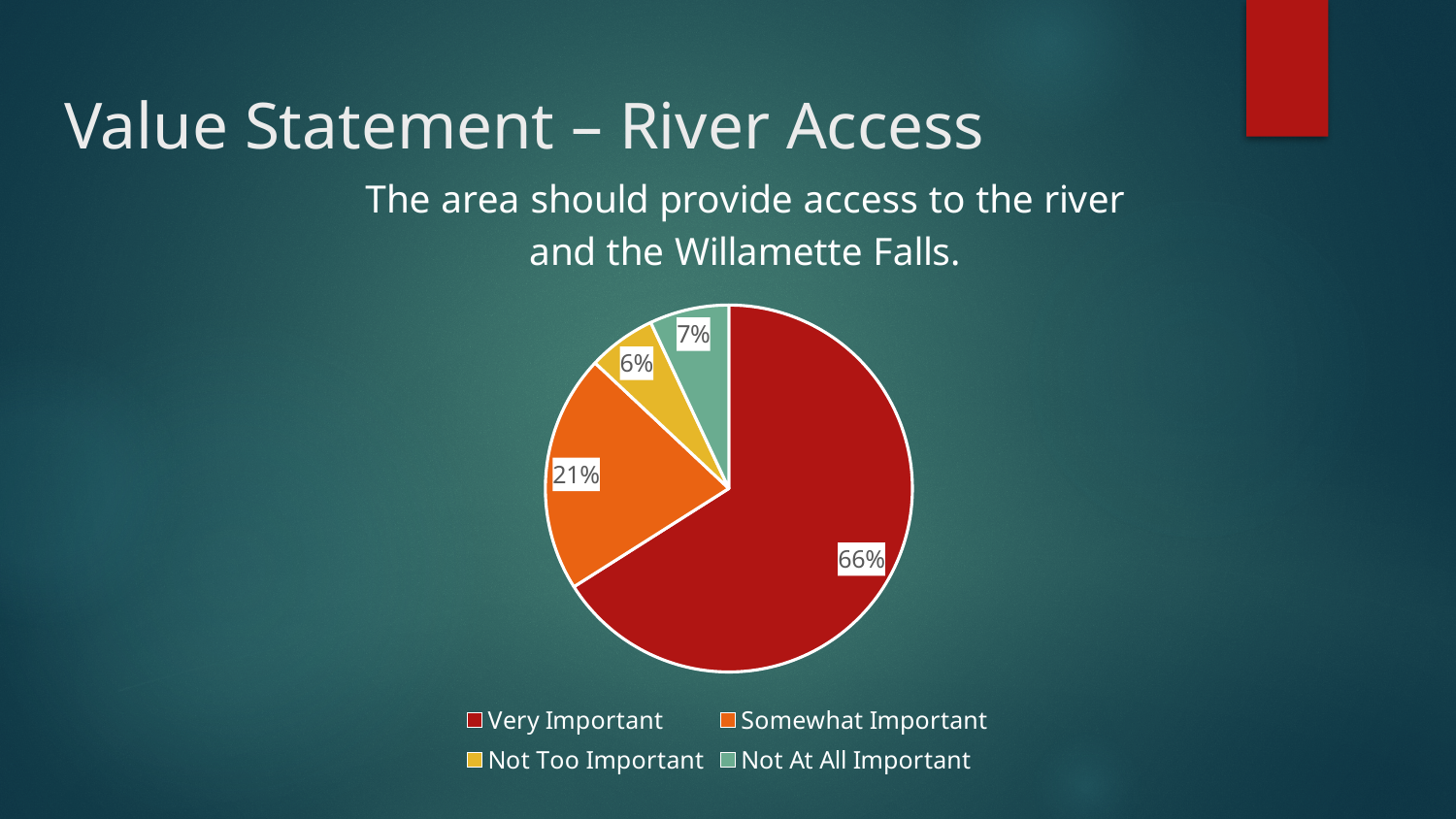
What is the combined share of Very Important and Somewhat Important? 87% How many categories does the legend list? 4 What percentage of respondents rated river access as Somewhat Important? 21% Which category has the largest share of the pie? Very Important What percentage of respondents rated river access as Not At All Important? 7% Which is larger, the share for Not At All Important or the share for Not Too Important? Not At All Important What kind of chart is shown on the slide? pie chart What percentage of respondents rated river access as Not Too Important? 6% Which category has the smallest share of the pie? Not Too Important What percentage of respondents rated river access as Very Important? 66% What is the difference in percentage points between Very Important and Somewhat Important? 45 What colour is the Very Important slice? red